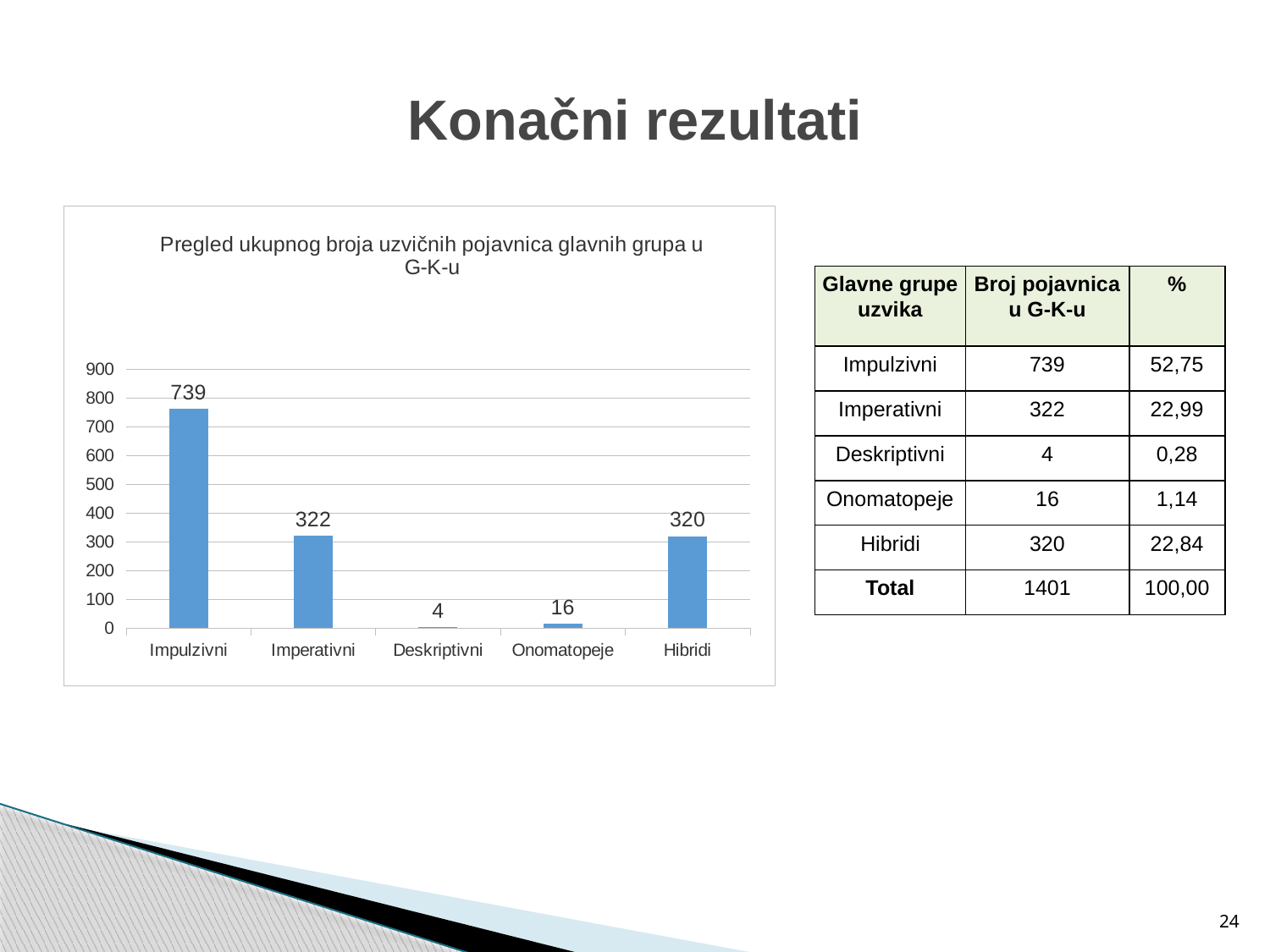
Which category has the lowest value? Deskriptivni Which category has the highest value? Impulzivni How many categories are shown on the x axis? 5 What is the value for Onomatopeje? 16 What kind of chart is shown? bar chart What is the difference between the values for Impulzivni and Imperativni? 417 What is the title of the chart? Pregled ukupnog broja uzvičnih pojavnica glavnih grupa u G-K-u What is the value for Hibridi? 320 Which is larger, the value for Imperativni or the value for Hibridi? Imperativni Is the value for Impulzivni greater or less than 700? greater What is the difference between the values for Onomatopeje and Deskriptivni? 12 What is the value for Impulzivni? 739